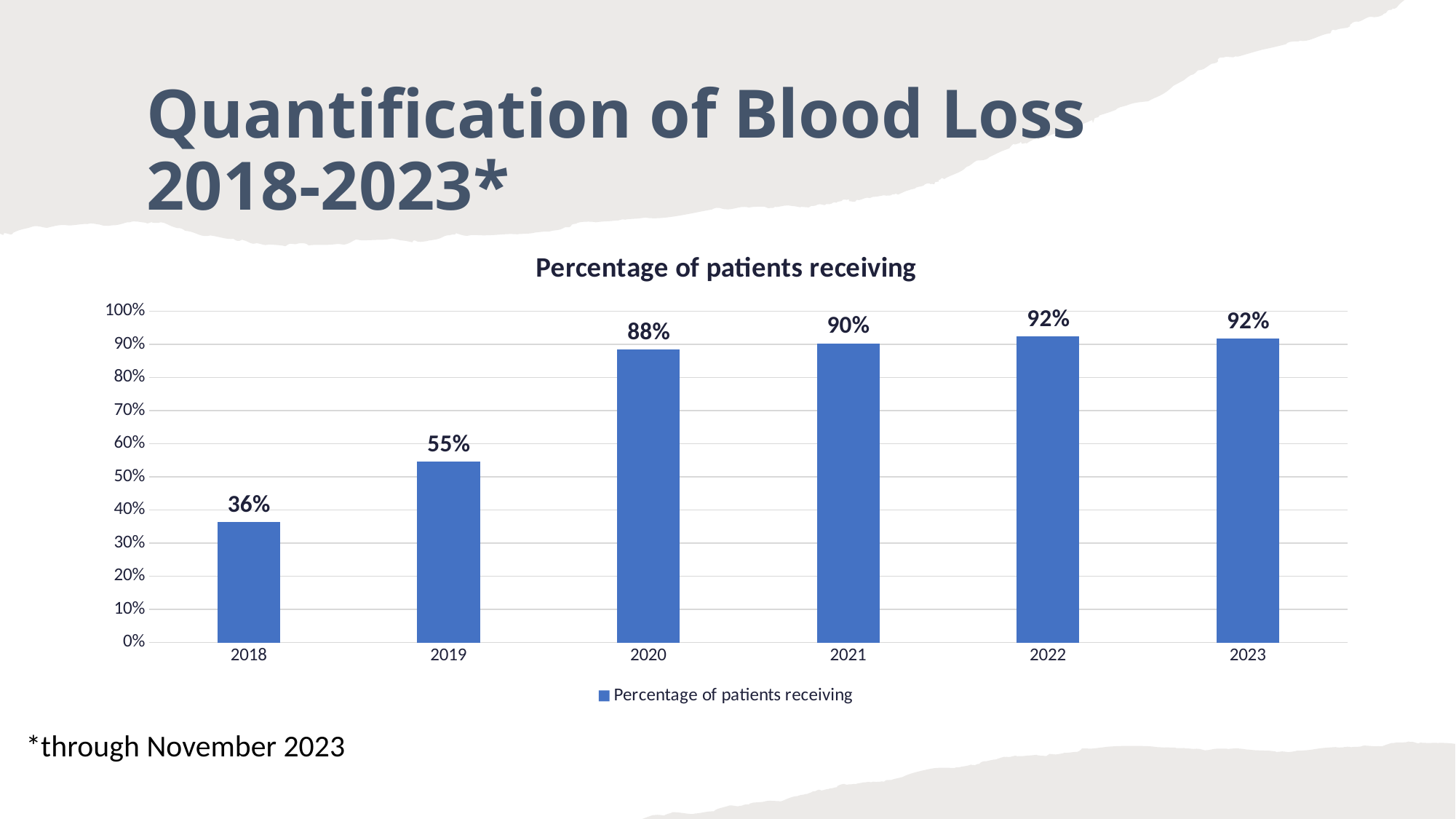
Is the value for 2019 greater or less than 50%? greater Which year has the larger value, 2019 or 2021? 2021 Which year has the lowest percentage of patients receiving quantification of blood loss? 2018 Do the values rise or fall from 2018 to 2022? Rise How many series does the chart legend list? 1 What kind of chart is shown on the slide? Bar chart What is the percentage of patients receiving quantification of blood loss in 2018? 36% How many years are shown on the x axis of the chart? 6 What is the difference in percentage points between 2020 and 2019? 33 What is the percentage of patients receiving quantification of blood loss in 2020? 88% What is the difference in percentage points between 2019 and 2018? 19 What is the percentage of patients receiving quantification of blood loss in 2023? 92%